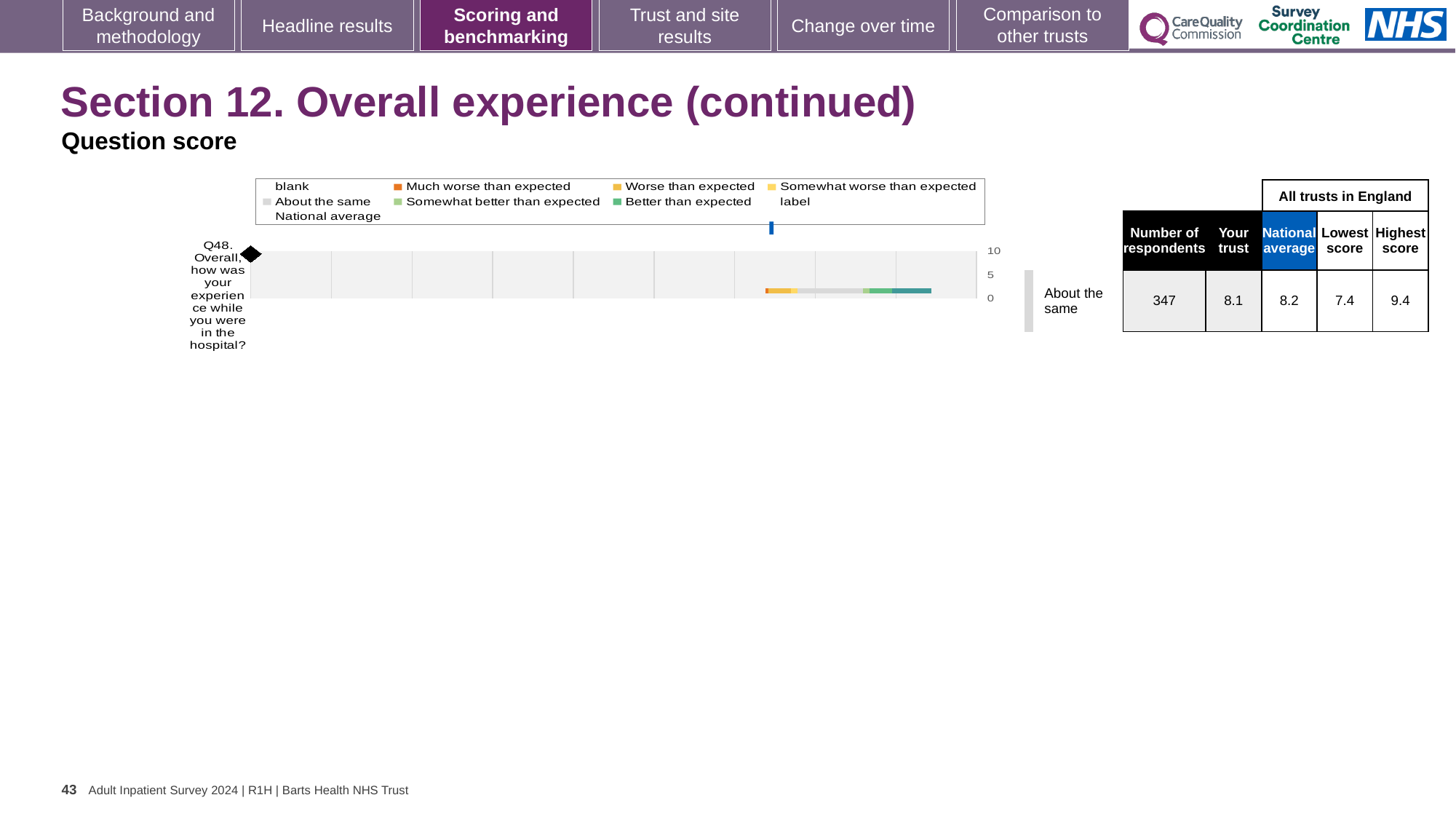
How many respondents answered Q48, according to the table next to the chart? 347 How many survey questions are plotted in the chart? 1 In the table next to the chart, what is the Highest score among all trusts in England for Q48? 9.4 What kind of chart is shown for Q48 on this slide? bar chart Which question is plotted in the chart? Q48. Overall, how was your experience while you were in the hospital? In the table next to the chart, what is the 'Your trust' score for Q48? 8.1 For Q48, what is the difference between the Highest score and the Lowest score in the table? 2.0 For Q48, which is larger: the 'Your trust' score or the National average score? National average What is the highest value shown on the chart's score axis? 10 In the table next to the chart, what is the Lowest score among all trusts in England for Q48? 7.4 What benchmark category is shown for Q48 next to the chart? About the same In the table next to the chart, what is the National average score for Q48? 8.2